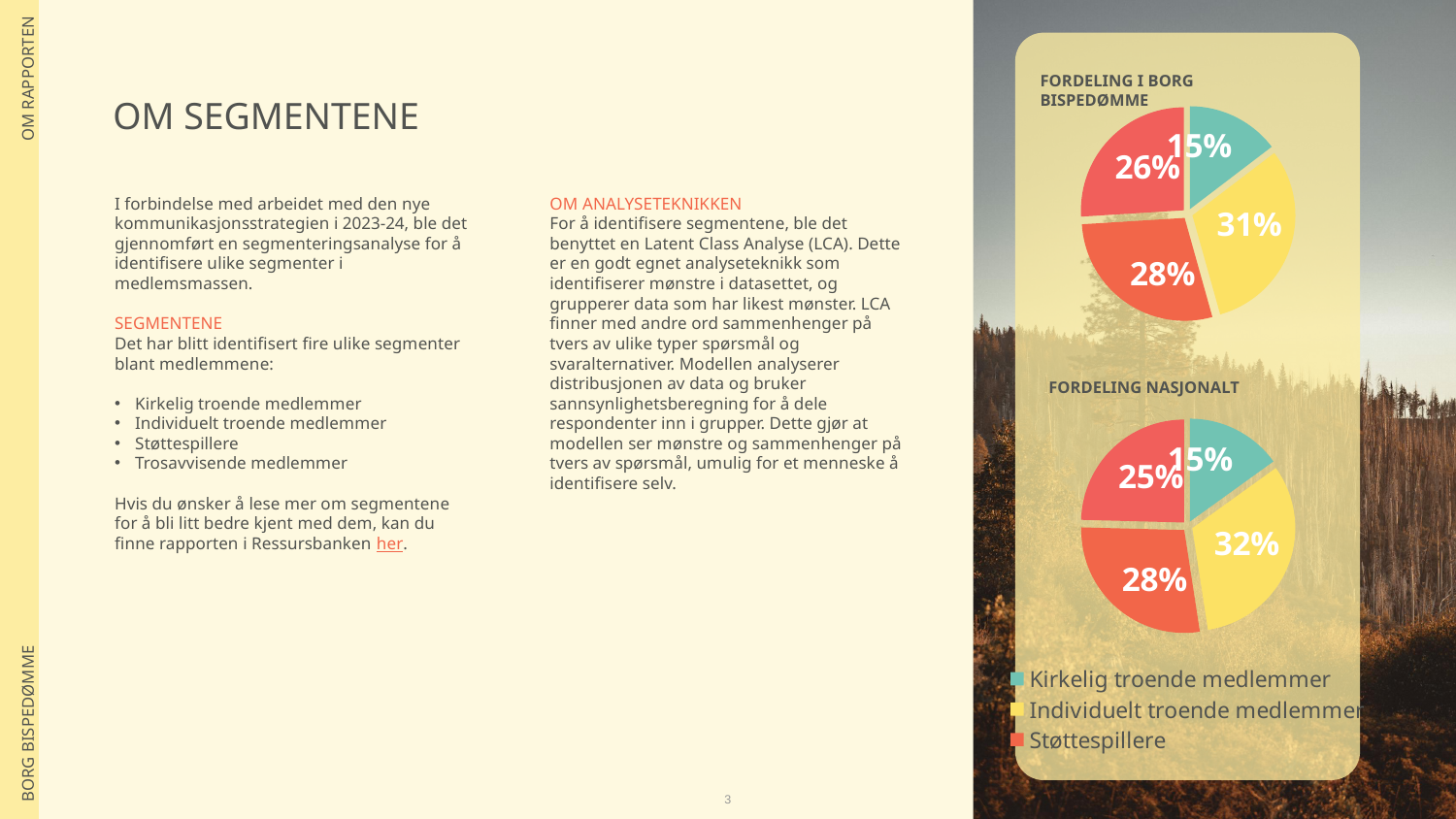
In the FORDELING NASJONALT chart, what is the smallest slice's value? 15% How many entries does the legend below the charts list? 3 Is the share for Individuelt troende medlemmer larger in the FORDELING I BORG BISPEDØMME chart or the FORDELING NASJONALT chart? FORDELING NASJONALT In the FORDELING NASJONALT chart, what share is shown for Kirkelig troende medlemmer? 15% How many slices does the FORDELING NASJONALT pie chart have? 4 In the FORDELING I BORG BISPEDØMME chart, what is the difference in percentage points between Individuelt troende medlemmer and Kirkelig troende medlemmer? 16 percentage points In the FORDELING I BORG BISPEDØMME chart, what share is shown for Individuelt troende medlemmer? 31% In the FORDELING NASJONALT chart, what share is shown for Individuelt troende medlemmer? 32% What kind of chart is used for FORDELING I BORG BISPEDØMME? Pie chart Which legend entry is shown in teal? Kirkelig troende medlemmer In the FORDELING I BORG BISPEDØMME chart, what is the largest slice's value? 31% In the FORDELING I BORG BISPEDØMME chart, what share is shown for Kirkelig troende medlemmer? 15%